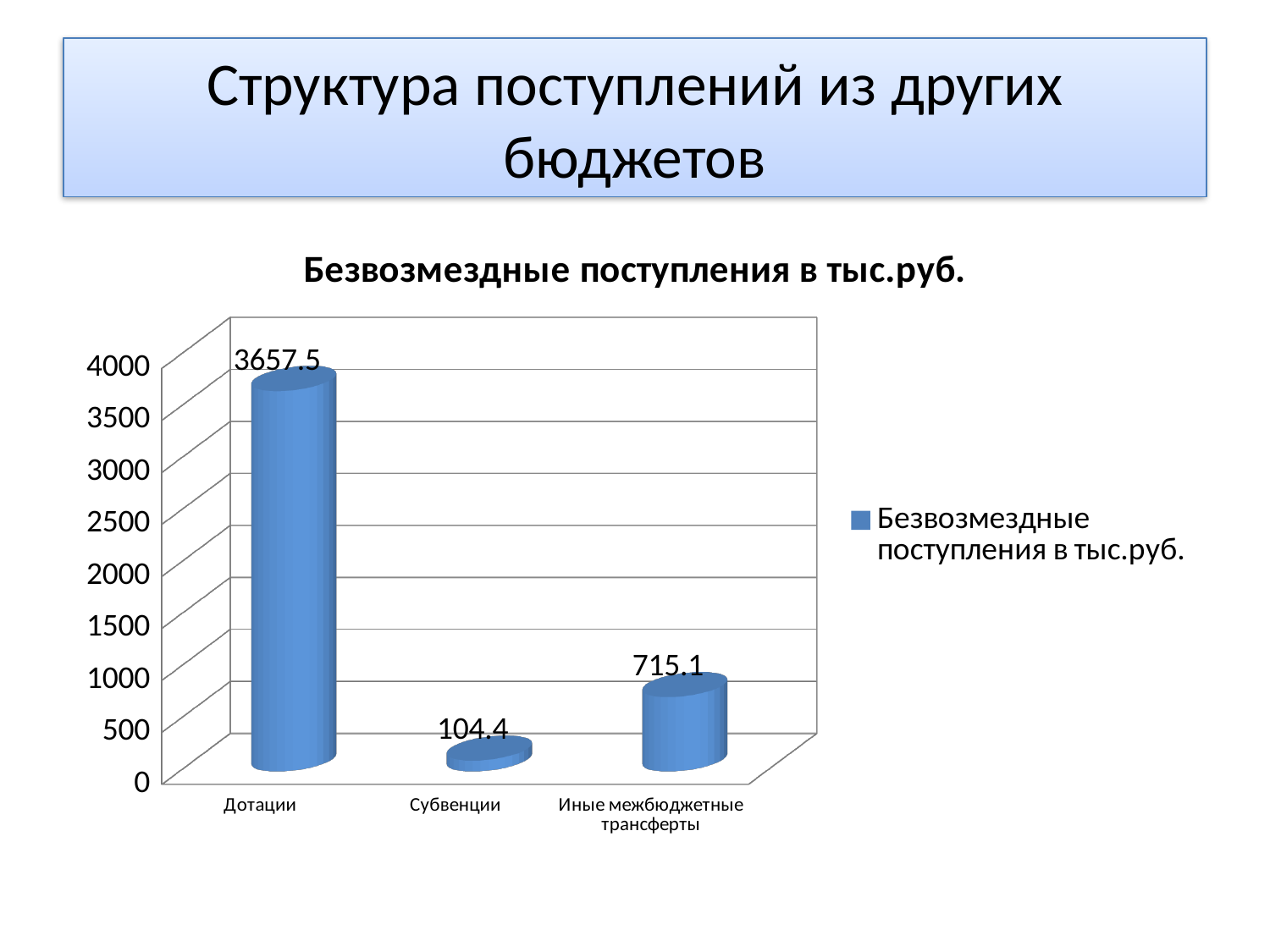
What is the value for Субвенции? 104.4 How many categories are shown on the chart? 3 Which category has the lowest value? Субвенции What kind of chart is shown on the slide? bar chart What is the value for Дотации? 3657.5 Which is larger, the value for Субвенции or the value for Иные межбюджетные трансферты? Иные межбюджетные трансферты Which category has the highest value? Дотации What is the value for Иные межбюджетные трансферты? 715.1 What is the difference between the values for Дотации and Иные межбюджетные трансферты? 2942.4 What is the difference between the values for Иные межбюджетные трансферты and Субвенции? 610.7 Is the value for Дотации greater or less than 3500? greater What is the title of the chart? Безвозмездные поступления в тыс.руб.